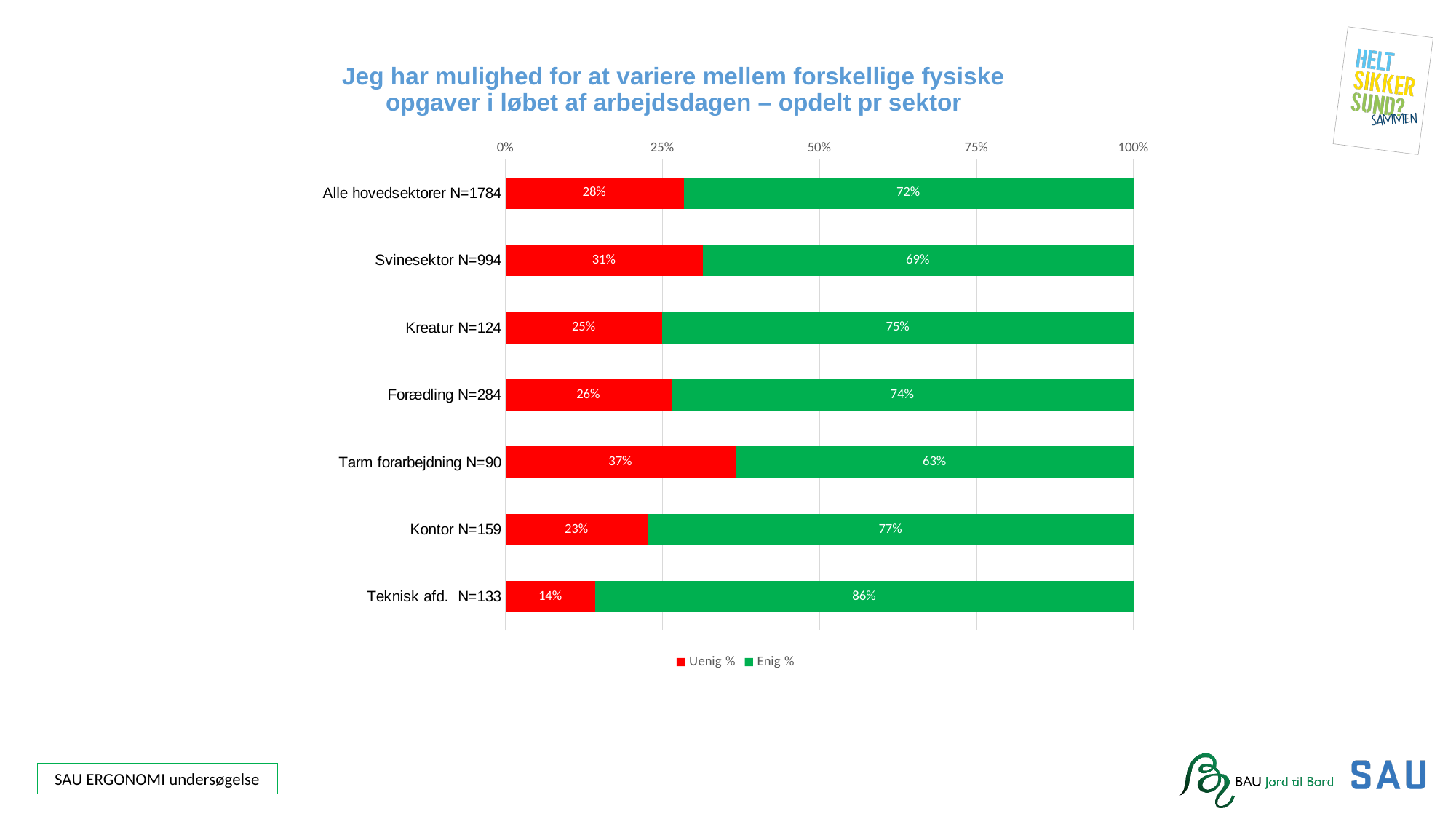
What is the Enig % value for Alle hovedsektorer N=1784? 72% What is the difference between the Enig % values for Kontor N=159 and Svinesektor N=994? 8% Which has a larger Uenig % value, Kreatur N=124 or Forædling N=284? Forædling N=284 What is the total of the stacked bar for Kreatur N=124? 100% Which category has the lowest Uenig % value? Teknisk afd. N=133 What is the Enig % value for Teknisk afd. N=133? 86% Which category has the highest Enig % value? Teknisk afd. N=133 What is the Uenig % value for Tarm forarbejdning N=90? 37% How many categories are shown on the chart? 7 What kind of chart is shown on the slide? Stacked bar chart How many series does the legend list? 2 Which category has the highest Uenig % value? Tarm forarbejdning N=90